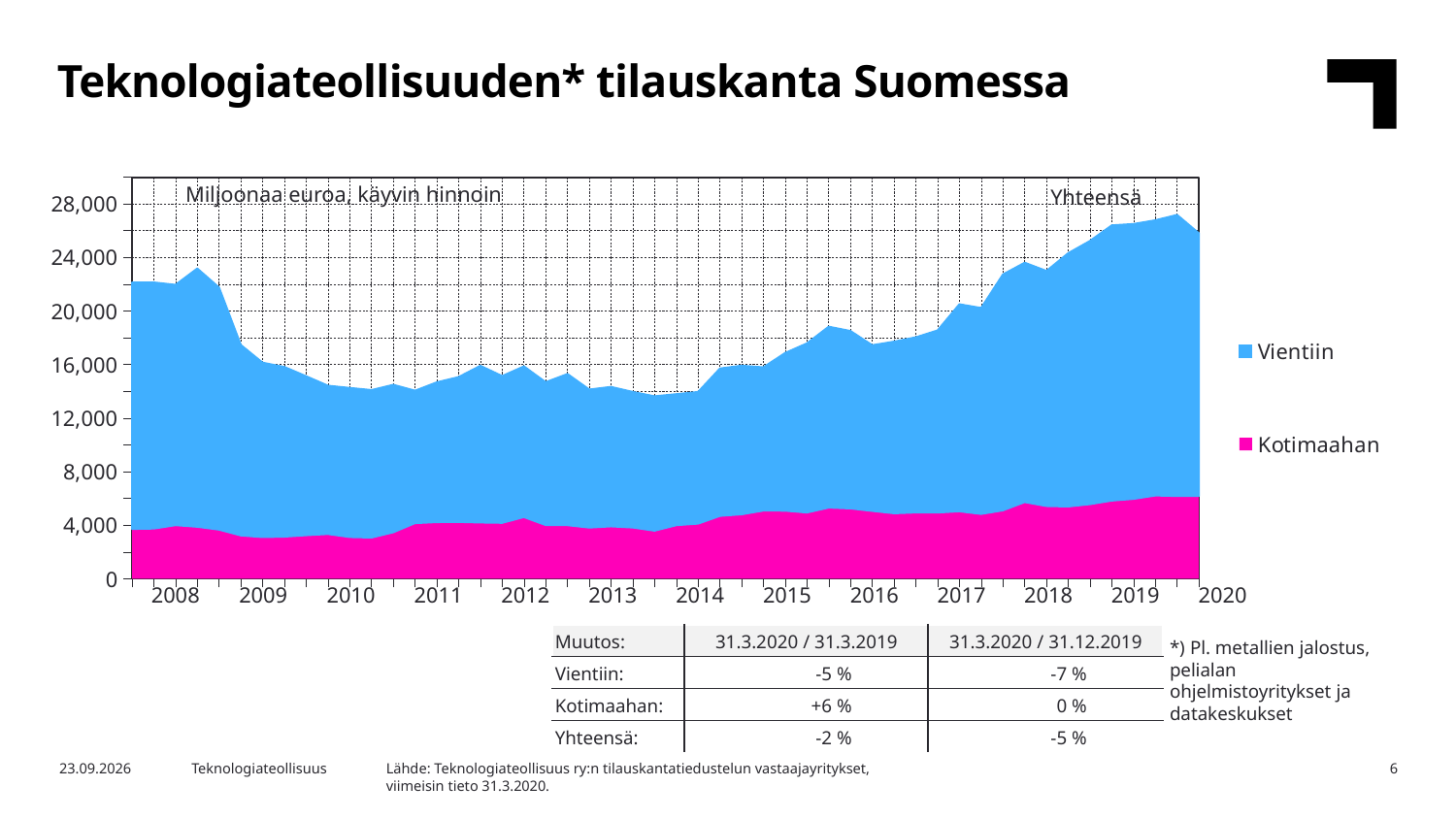
How many year labels are shown on the x axis? 13 How many series does the legend list? 2 What unit is stated in the label at the top left of the chart? Miljoonaa euroa, käyvin hinnoin Which is larger at 2020, the Vientiin series or the Kotimaahan series? Vientiin Is the total (Yhteensä) at 2014 greater or less than 16,000? less Does the total (Yhteensä) rise or fall between 2014 and 2019? Rises Is the total (Yhteensä) at 2020 greater or less than 24,000? greater Is the total (Yhteensä) at 2008 greater or less than 20,000? greater What kind of chart is shown on the slide? Area chart Which two series are listed in the chart legend? Vientiin and Kotimaahan